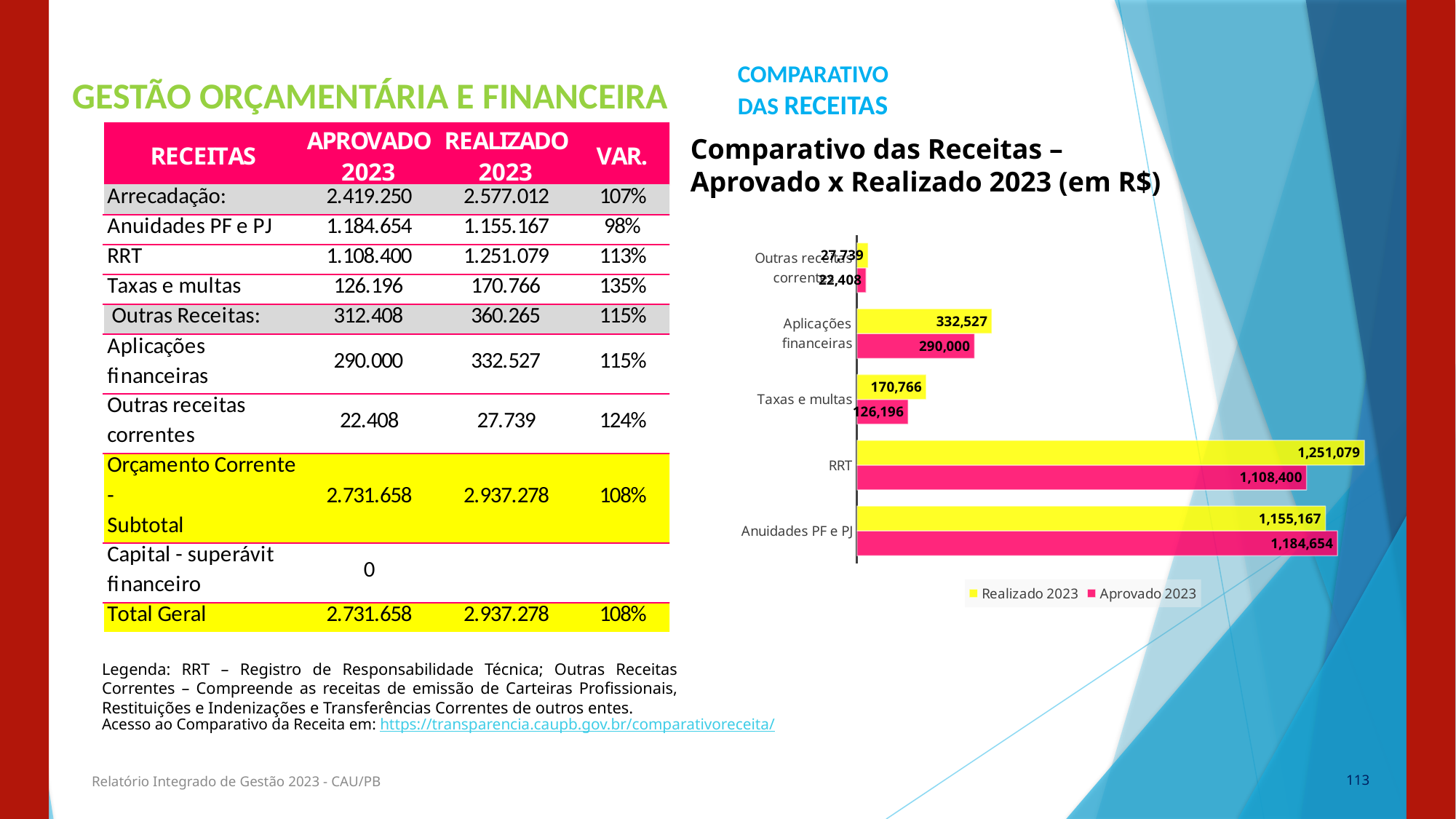
What is the Aprovado 2023 value for Aplicações financeiras in the chart? 290,000 What is the Realizado 2023 value for RRT in the chart? 1,251,079 What is the difference between the Realizado 2023 and Aprovado 2023 values for RRT in the chart? 142,679 How many series does the chart legend list? 2 What kind of chart is shown on the slide? Bar chart Which category has the highest Realizado 2023 value in the chart? RRT What is the Aprovado 2023 value for Anuidades PF e PJ in the chart? 1,184,654 For Anuidades PF e PJ, which is larger in the chart: Realizado 2023 or Aprovado 2023? Aprovado 2023 Which colour represents the Realizado 2023 series in the chart? Yellow Which category has the lowest Aprovado 2023 value in the chart? Outras receitas correntes What is the Realizado 2023 value for Taxas e multas in the chart? 170,766 How many categories are plotted in the chart? 5